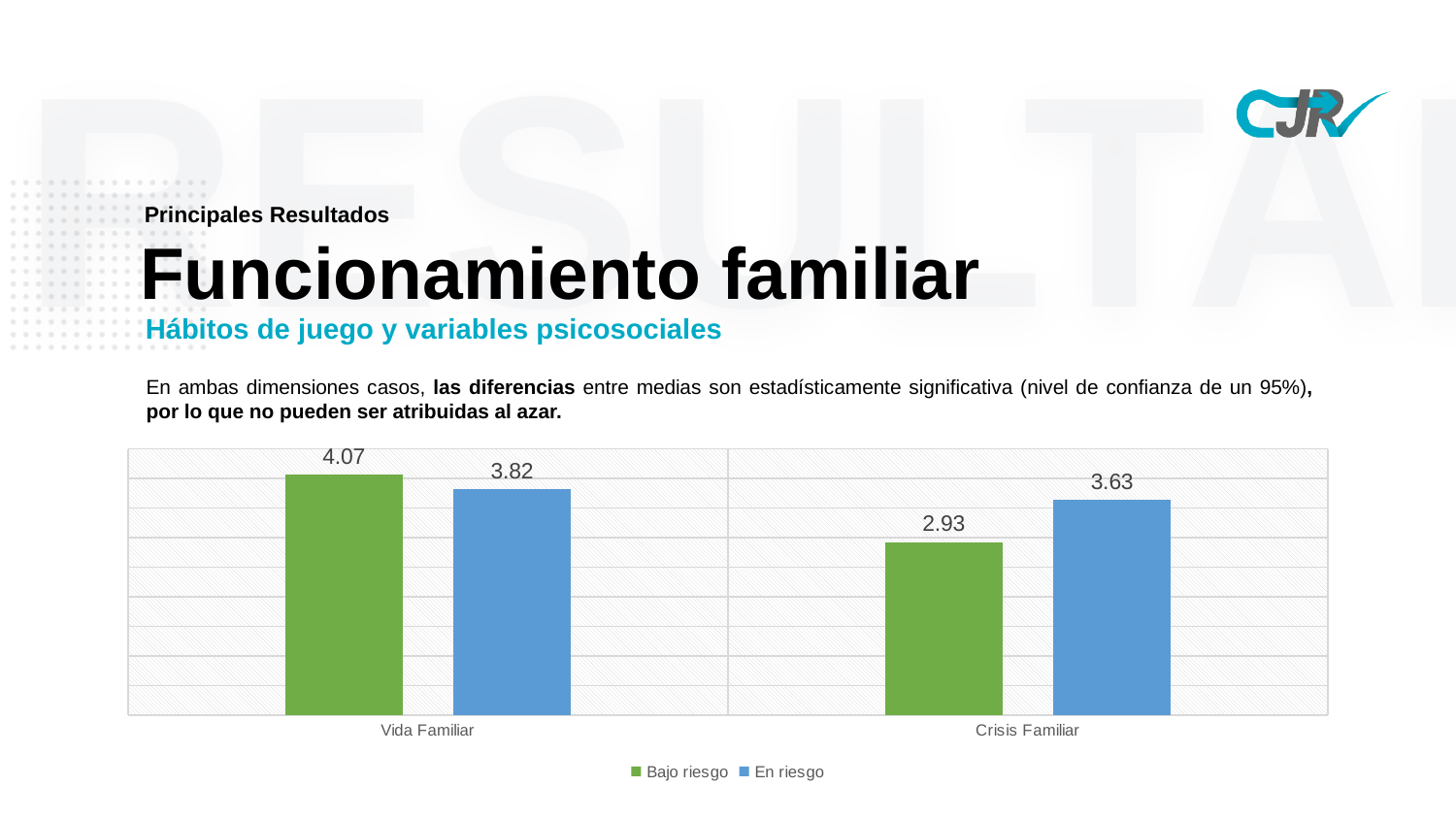
What is the value for En riesgo in the Crisis Familiar category? 3.63 What is the value for Bajo riesgo in the Vida Familiar category? 4.07 What is the value for En riesgo in the Vida Familiar category? 3.82 What type of chart is shown on the slide? Bar chart What is the difference between the Bajo riesgo and En riesgo values for Vida Familiar? 0.25 Which bar has the highest value in the chart? Bajo riesgo, Vida Familiar What is the difference between the En riesgo and Bajo riesgo values for Crisis Familiar? 0.70 How many series does the legend list? 2 Which bar has the lowest value in the chart? Bajo riesgo, Crisis Familiar In the Crisis Familiar category, which series has the larger value, Bajo riesgo or En riesgo? En riesgo What is the value for Bajo riesgo in the Crisis Familiar category? 2.93 How many categories are shown on the x axis of the chart? 2